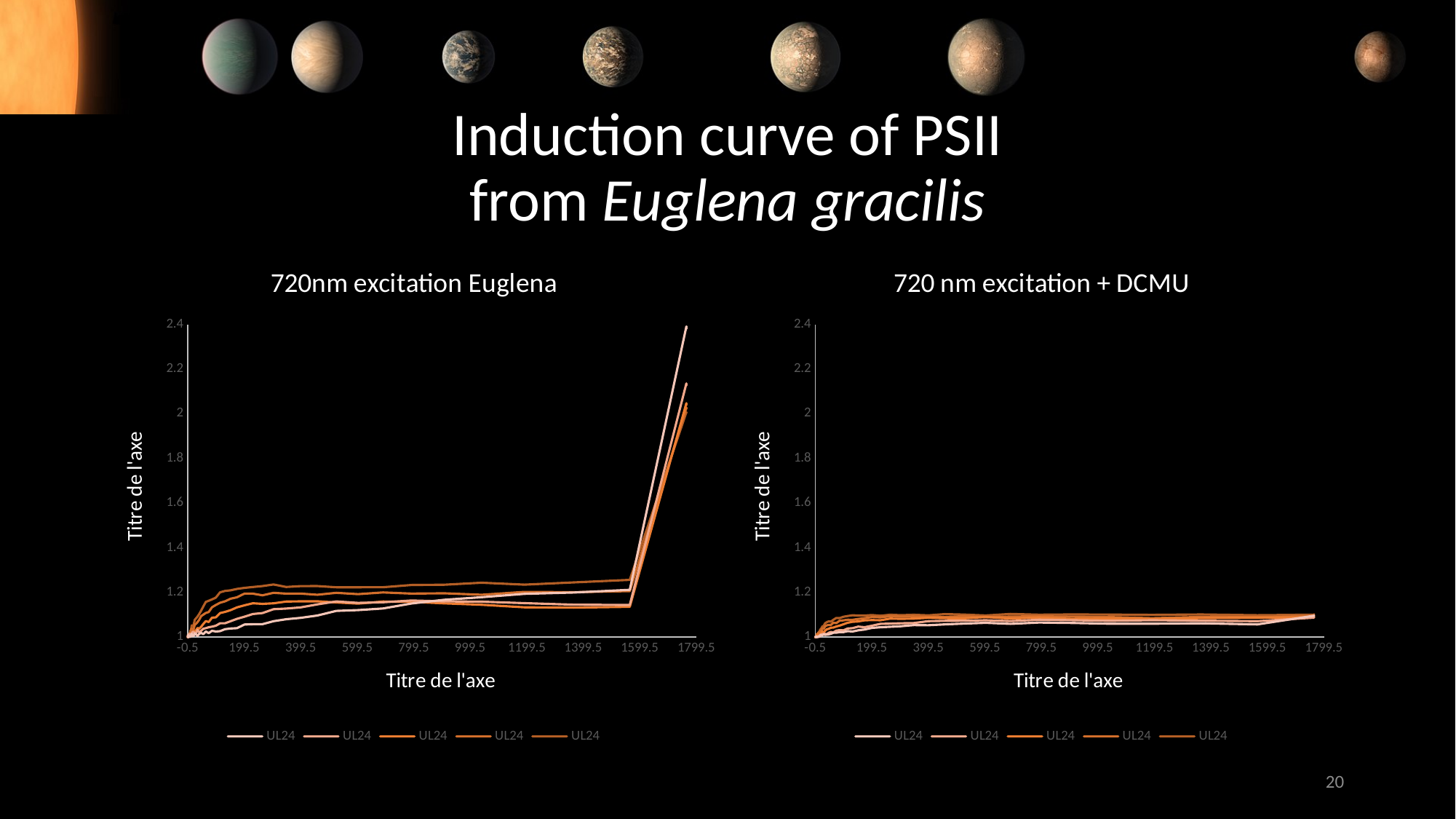
Which chart reaches higher values at the right end of the x axis, '720nm excitation Euglena' or '720 nm excitation + DCMU'? 720nm excitation Euglena In the '720nm excitation Euglena' chart, are the values of the series around x = 999.5 greater or less than 1.4? less How many series does the legend of the '720nm excitation Euglena' chart list? 5 In the '720nm excitation Euglena' chart, is the highest value reached at the right end of the x axis greater or less than 2.2? greater What is the highest tick value shown on the vertical axis of the '720 nm excitation + DCMU' chart? 2.4 What label is shown on the vertical axis of the '720nm excitation Euglena' chart? Titre de l'axe What kind of chart is the '720 nm excitation + DCMU' chart? line chart How many series does the legend of the '720 nm excitation + DCMU' chart list? 5 In the '720 nm excitation + DCMU' chart, are the values of all series at the right end of the x axis greater or less than 1.2? less What kind of chart is the '720nm excitation Euglena' chart? line chart What is the title of the chart on the right of the slide? 720 nm excitation + DCMU In the '720nm excitation Euglena' chart, do the series rise or fall sharply after x = 1599.5? rise